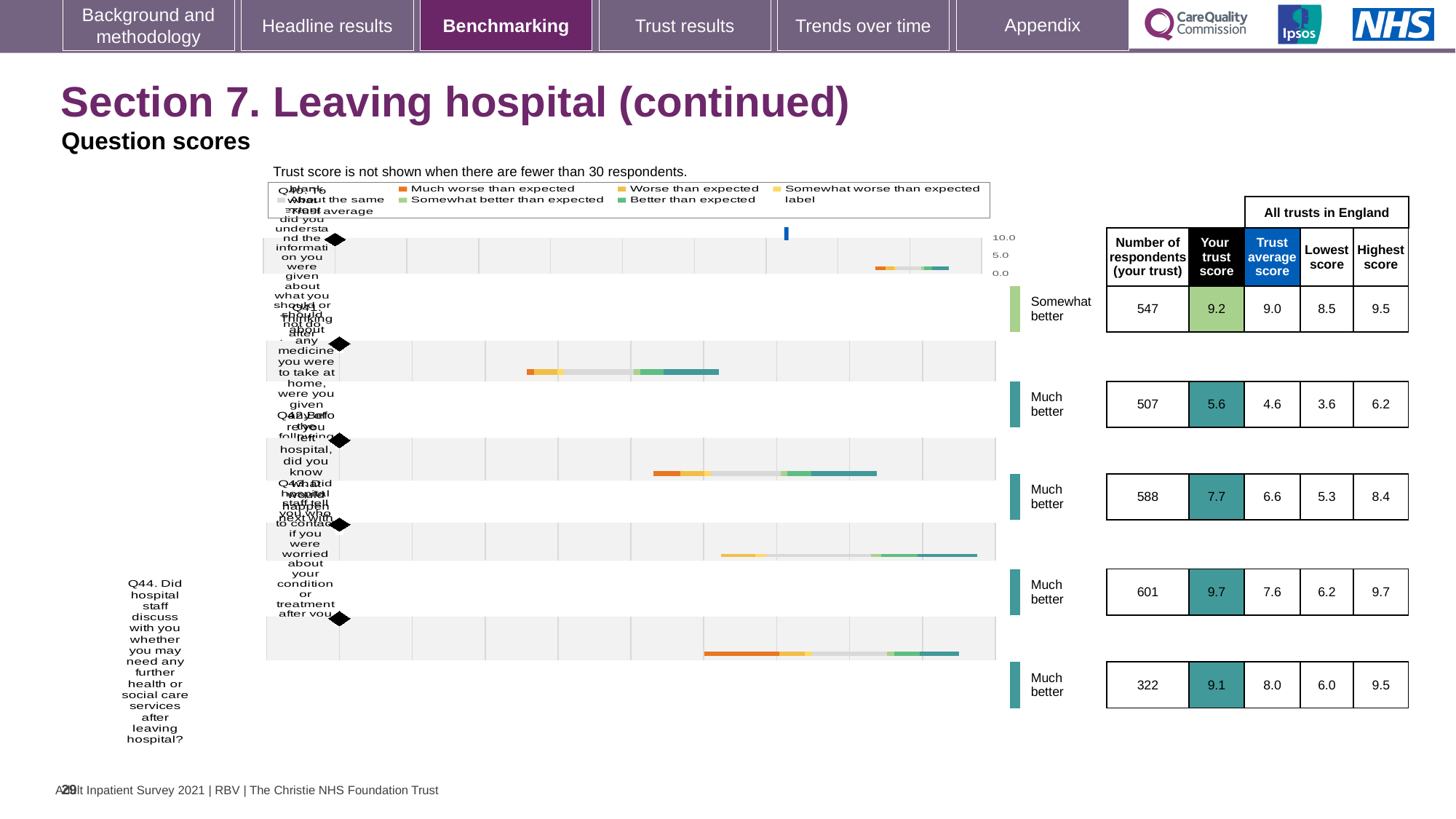
How many question rows are plotted in the chart? 5 Is the trust score for the second row (Q41) larger or smaller than the trust score for the third row (Q42)? Smaller What is the trust average score for the bottom row (Q44) of the chart? 8.0 Which row of the chart has the highest trust score? The fourth row (Q43) What is the trust score for the first (top) row of the chart? 9.2 Which row of the chart has the lowest trust score? The second row (Q41) What is the lowest score across all trusts in England for the second row (Q41)? 3.6 What is the difference between the trust score and the trust average score for the fourth row (Q43)? 2.1 What is the benchmark category shown for the first (top) row of the chart? Somewhat better What is the difference between the highest score and the lowest score for the bottom row (Q44)? 3.5 How many respondents answered Q44, the bottom row of the chart? 322 What is the trust score for Q44 (whether you may need further health or social care services after leaving hospital), the bottom row of the chart? 9.1